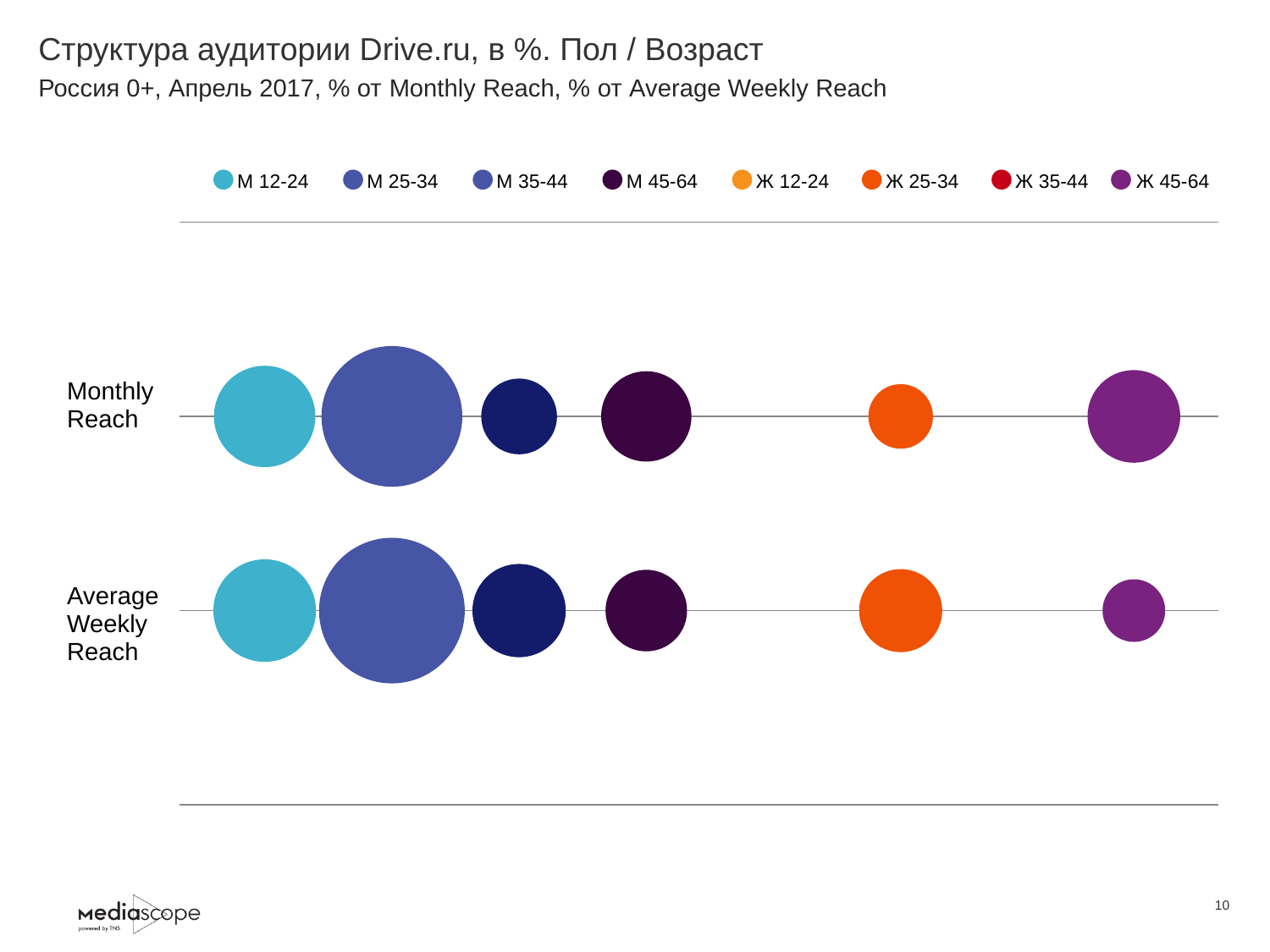
For Ж 45-64, which row has the larger bubble: Monthly Reach or Average Weekly Reach? Monthly Reach What is the title of the chart on the slide? Структура аудитории Drive.ru, в %. Пол / Возраст What kind of chart is shown on the slide? Bubble chart What is the first series listed in the legend? М 12-24 How many series does the legend list? 8 Which series has the largest bubble in the Average Weekly Reach row? М 25-34 Which series has the largest bubble in the Monthly Reach row? М 25-34 Which series has the smallest bubble in the Average Weekly Reach row? Ж 45-64 In the Monthly Reach row, which bubble is larger: М 25-34 or М 35-44? М 25-34 In the Monthly Reach row, which bubble is larger: М 45-64 or Ж 25-34? М 45-64 How many rows (categories) are plotted on the chart? 2